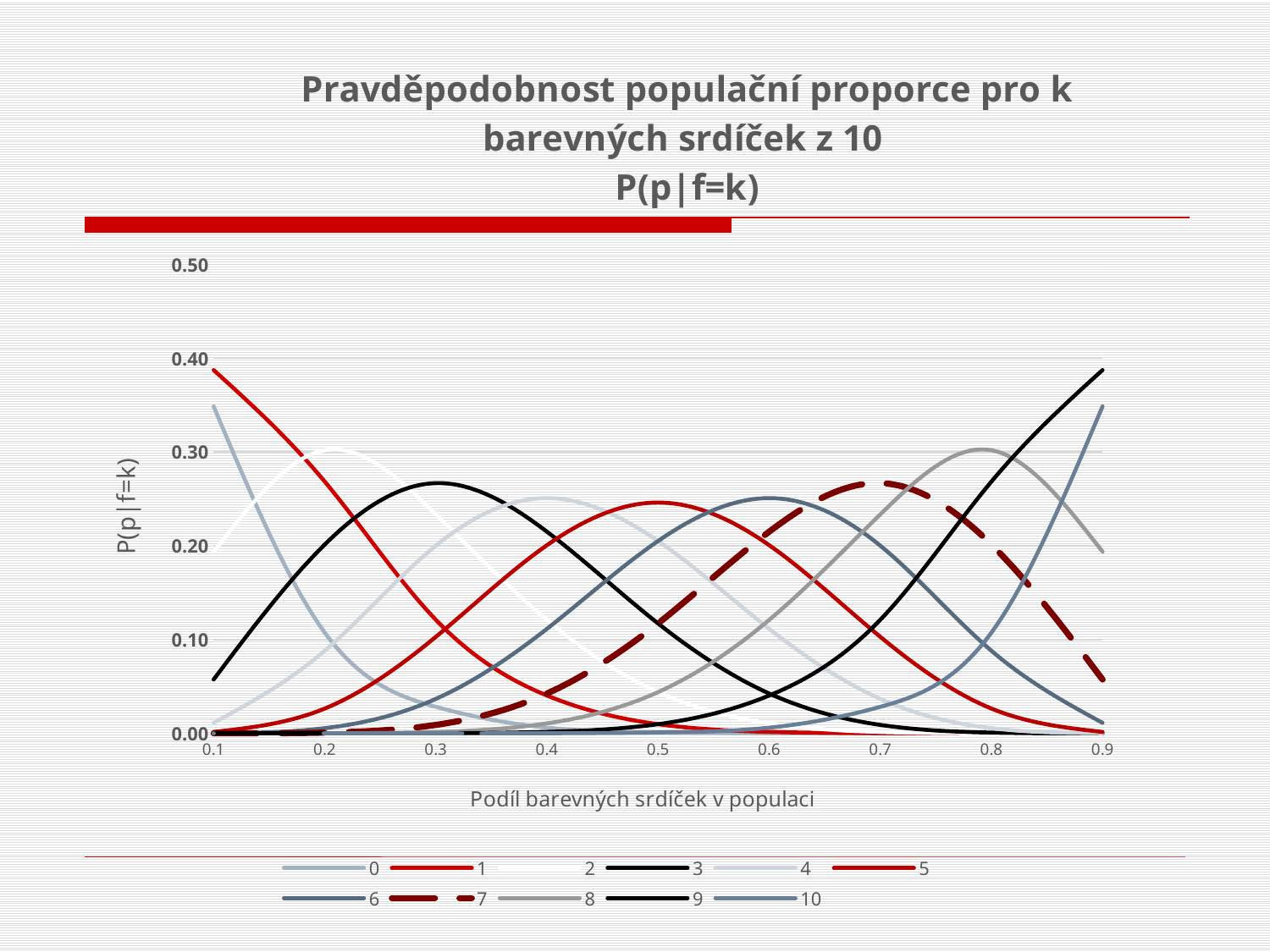
How many tick values are labelled on the x axis? 9 Is the value of series 1 at x = 0.1 greater or less than 0.30? greater At x = 0.5, which has the larger value: series 5 or series 7? series 5 Does the value of series 1 rise or fall as x increases from 0.1 to 0.9? fall What kind of chart is shown on the slide? line chart Does the value of series 9 rise or fall as x increases from 0.1 to 0.9? rise What is the label of the x axis? Podíl barevných srdíček v populaci How many series does the legend list? 11 Which series has the highest value at x = 0.1? 1 Is the value of series 9 at x = 0.9 greater or less than 0.30? greater What is the label of the y axis? P(p|f=k) Is the value of series 7 at x = 0.9 greater or less than 0.10? less